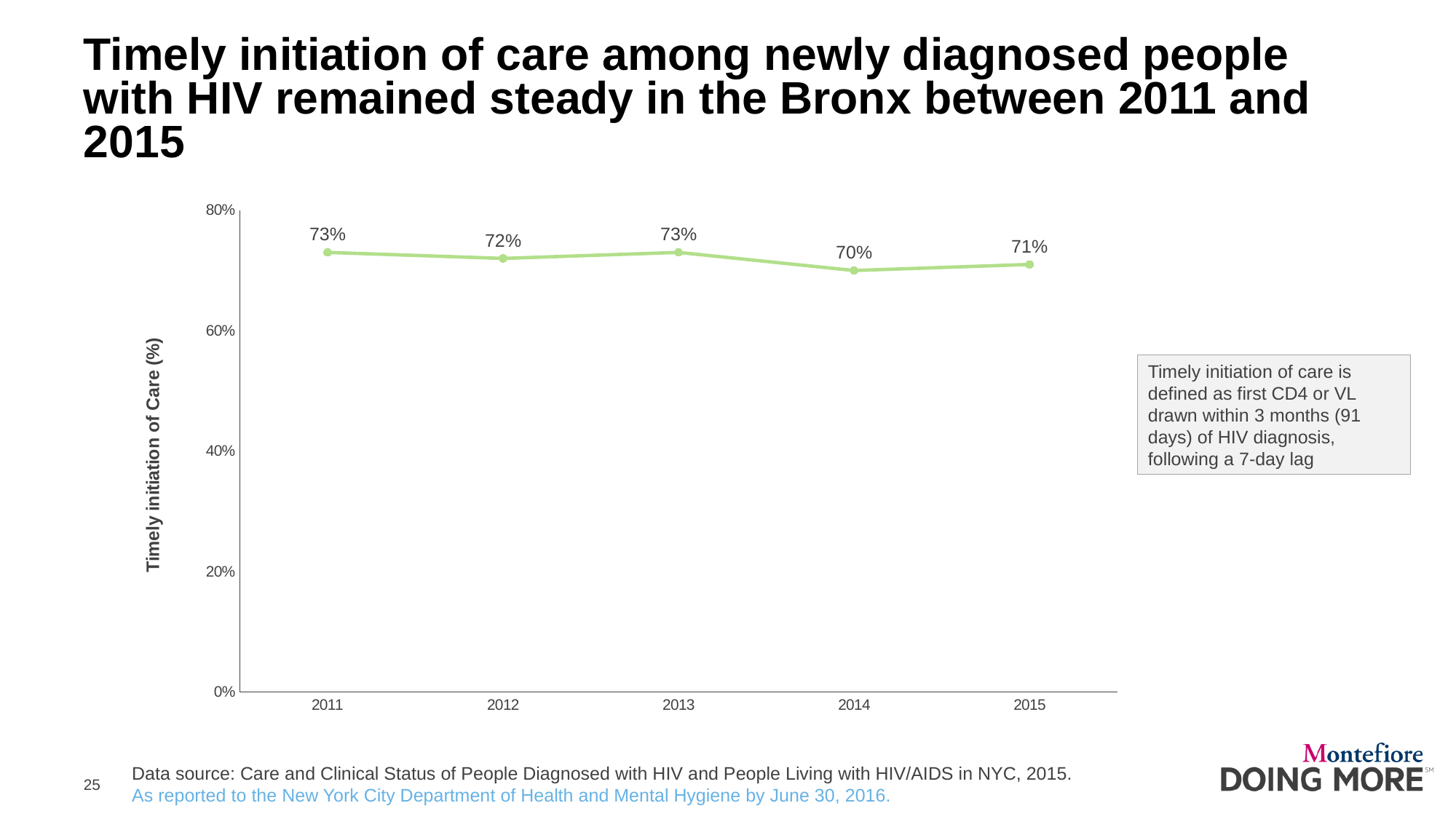
Which year had the lowest timely initiation of care percentage? 2014 What is the highest value shown on the vertical axis? 80% How many years are plotted on the chart? 5 Did the timely initiation of care percentage rise or fall from 2014 to 2015? rise What kind of chart is shown on the slide? line chart Is the value for 2013 greater or less than 60%? greater What was the timely initiation of care percentage in 2011? 73% Which is larger, the value for 2012 or the value for 2014? 2012 What was the timely initiation of care percentage in 2014? 70% What is the label on the vertical axis of the chart? Timely initiation of Care (%) What was the timely initiation of care percentage in 2015? 71% What is the difference between the 2011 value and the 2014 value? 3%